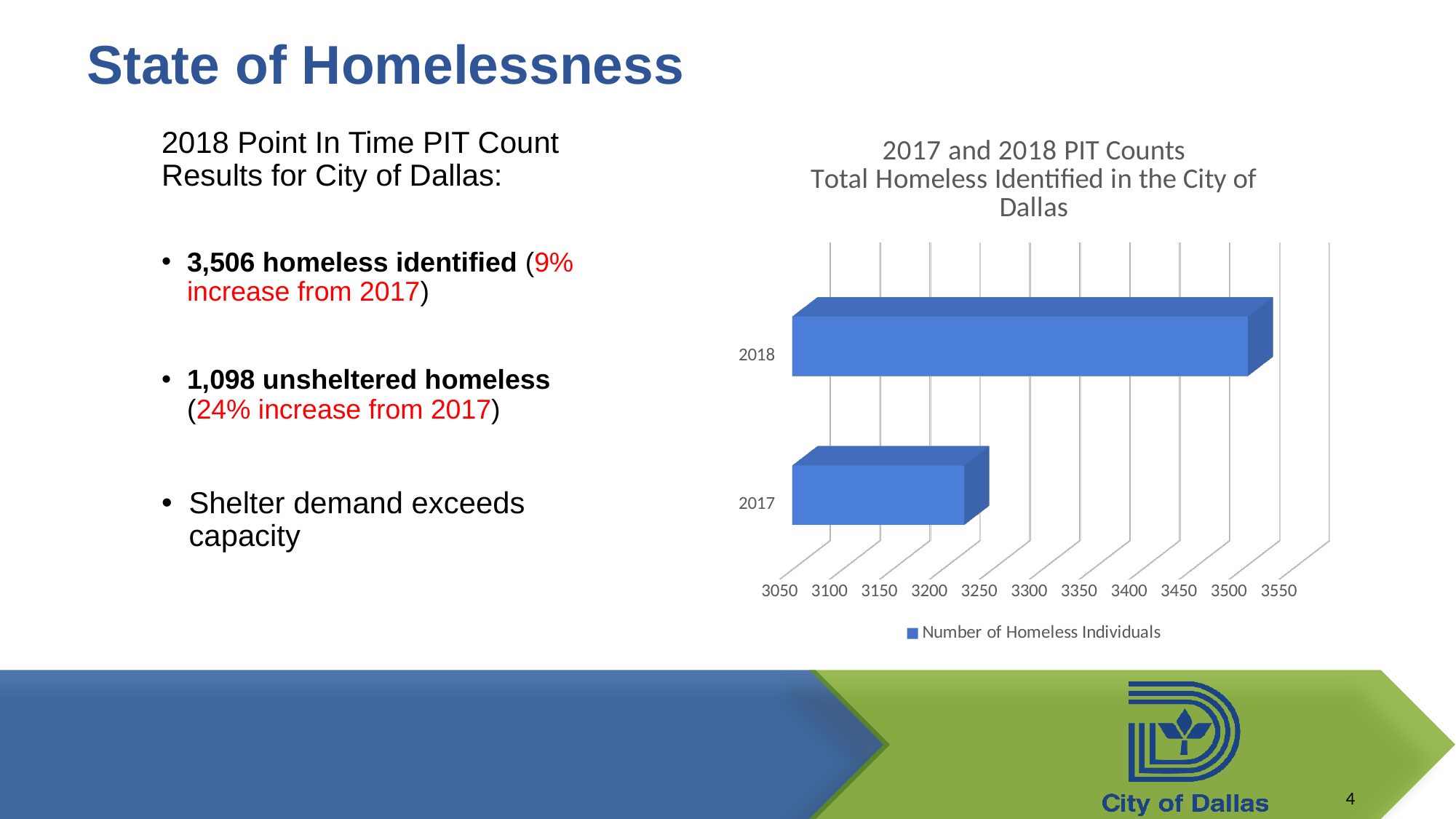
How many series does the chart legend list? 1 Is the value for 2018 greater or less than 3400? greater Is the value for 2017 greater or less than 3150? greater How many years (categories) are plotted in the chart? 2 Which year has the higher number of homeless individuals in the chart? 2018 Is the bar for 2018 longer or shorter than the bar for 2017? longer What kind of chart is shown on the slide? bar chart What is the title of the chart? 2017 and 2018 PIT Counts Total Homeless Identified in the City of Dallas Which year has the lower number of homeless individuals in the chart? 2017 What series name is shown in the chart legend? Number of Homeless Individuals Does the number of homeless individuals rise or fall from 2017 to 2018? rise